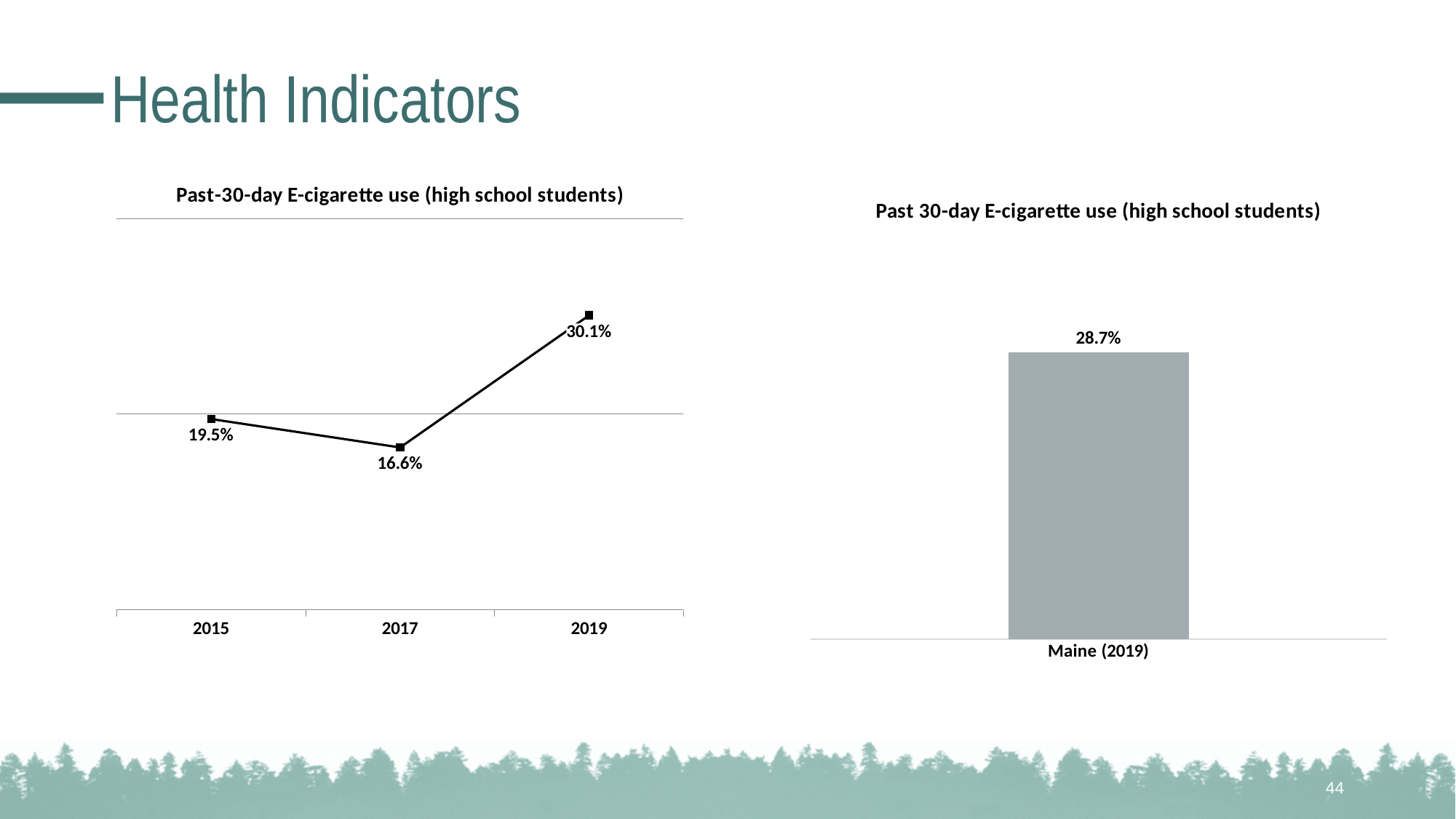
In the left chart (line chart), what is the difference between the 2019 value and the 2017 value? 13.5% What kind of chart is the right chart (Past 30-day E-cigarette use, Maine)? Bar chart In the left chart (line chart), what is the difference between the 2015 value and the 2017 value? 2.9% In the left chart (line chart), which year has the highest value? 2019 In the left chart (Past-30-day E-cigarette use, line chart), what is the value for 2019? 30.1% Which is larger: the 2019 value in the left line chart or the Maine (2019) value in the right bar chart? The 2019 value in the left line chart (30.1%) In the right chart (Past 30-day E-cigarette use, bar chart), what is the value for Maine (2019)? 28.7% In the left chart (Past-30-day E-cigarette use, line chart), what is the value for 2017? 16.6% In the left chart (line chart), which year has the lowest value? 2017 In the left chart (Past-30-day E-cigarette use, line chart), what is the value for 2015? 19.5% In the left chart (line chart), does the value rise or fall from 2017 to 2019? Rise How many data points are plotted in the left chart (line chart)? 3